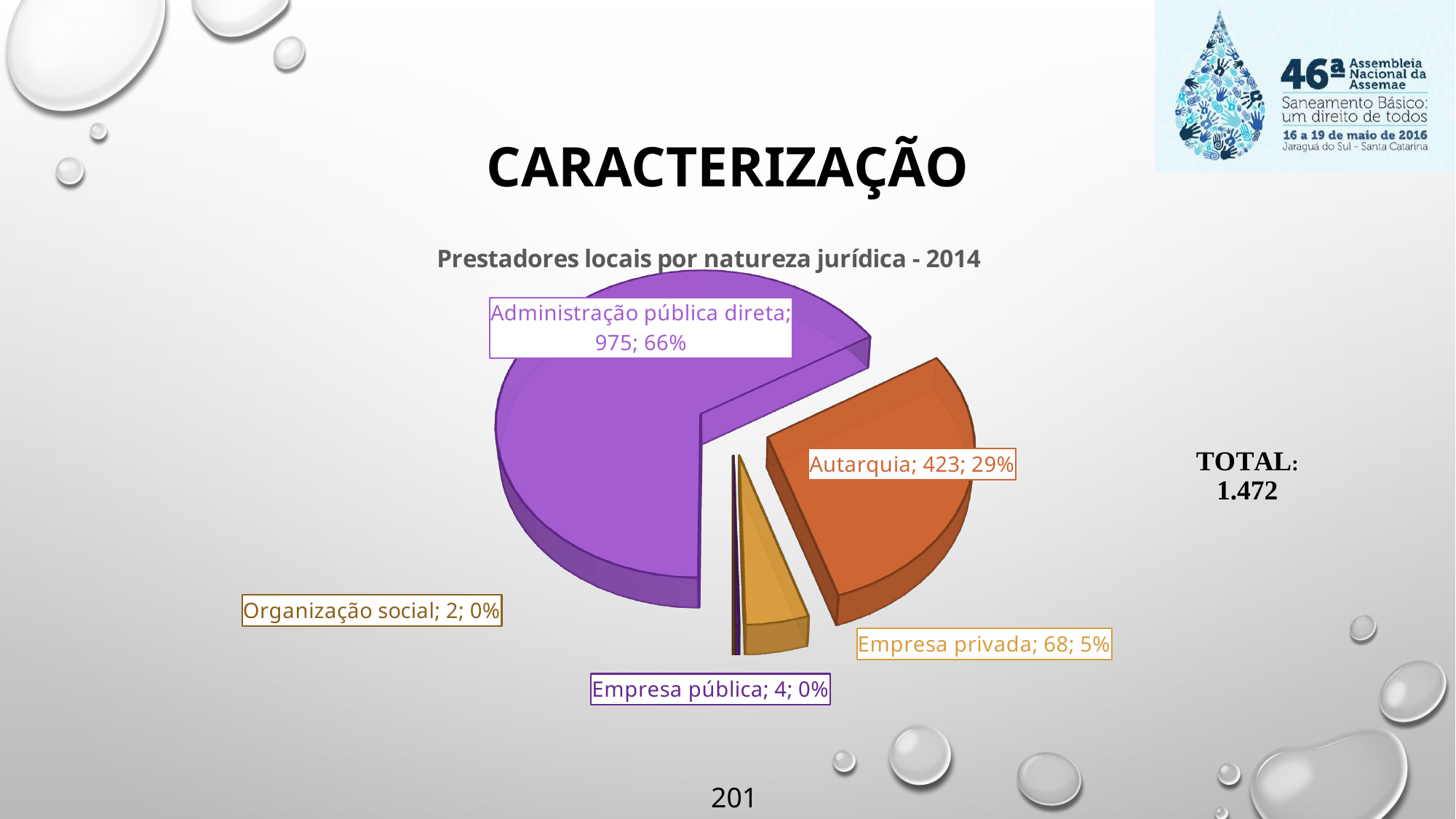
What is the value for Autarquia? 423 What is the difference between the values for Administração pública direta and Autarquia? 552 Which category has the smallest slice? Organização social How many categories does the pie chart show? 5 What is the value for Empresa pública? 4 What is the value for Administração pública direta? 975 What share of the pie does Autarquia represent? 29% What is the title of the chart? Prestadores locais por natureza jurídica - 2014 Which category has the largest slice? Administração pública direta What is the value for Empresa privada? 68 What kind of chart is shown on the slide? Pie chart Which is larger, the value for Empresa privada or the value for Empresa pública? Empresa privada